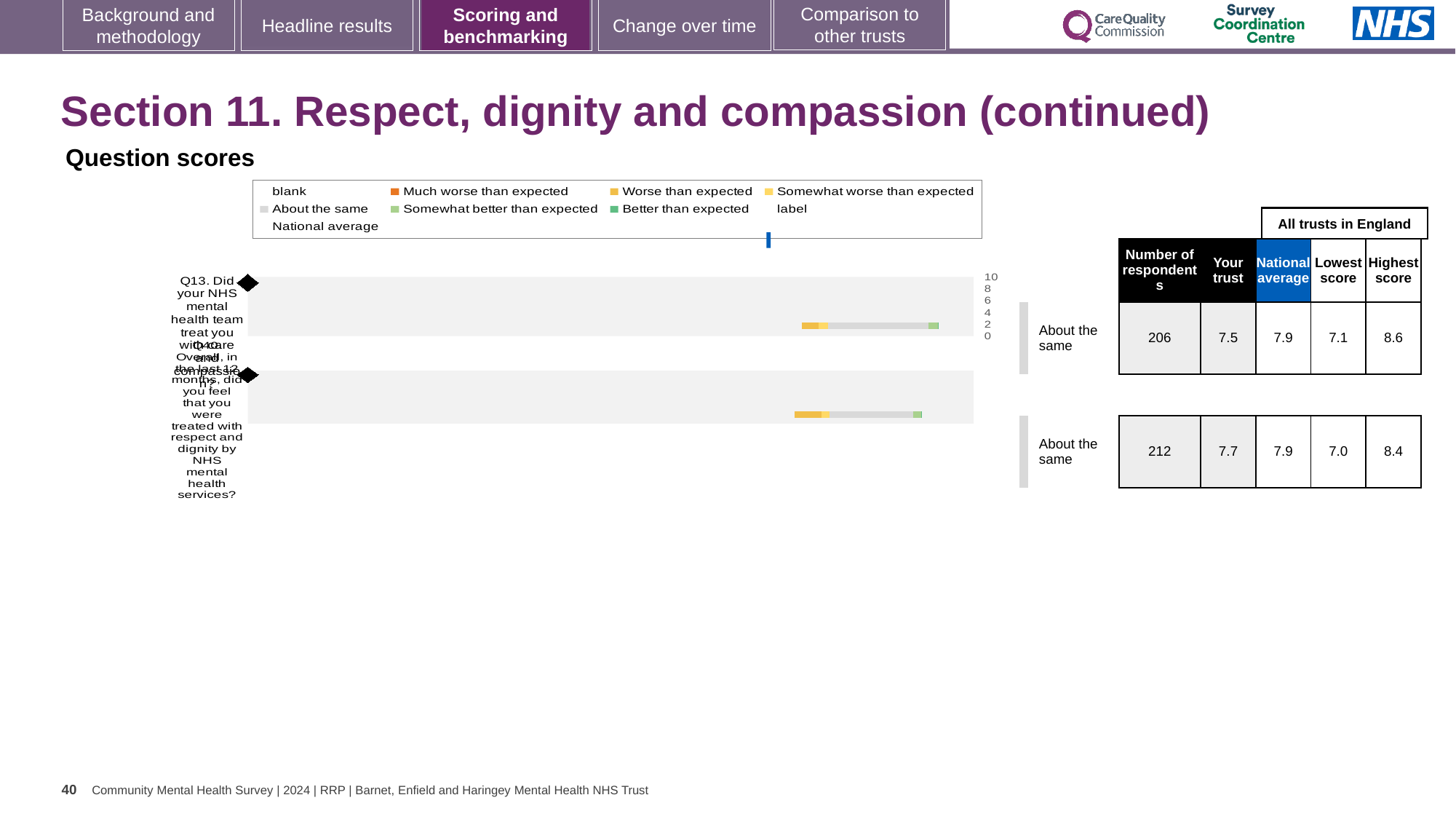
What is the 'Your trust' score for Q40? 7.7 How many questions (categories) are plotted in the question scores chart? 2 Which question has the higher 'Your trust' score, Q13 or Q40? Q40 How many respondents answered Q40? 212 What is the highest score among all trusts in England for Q13? 8.6 What is the lowest score among all trusts in England for Q40? 7.0 What is the national average score for Q13? 7.9 What is the difference between the national average and the 'Your trust' score for Q13? 0.4 What benchmark category is shown for Q13? About the same Which legend entry is shown in orange? Much worse than expected What is the 'Your trust' score for Q13? 7.5 What kind of chart is used to show the question scores on this slide? bar chart